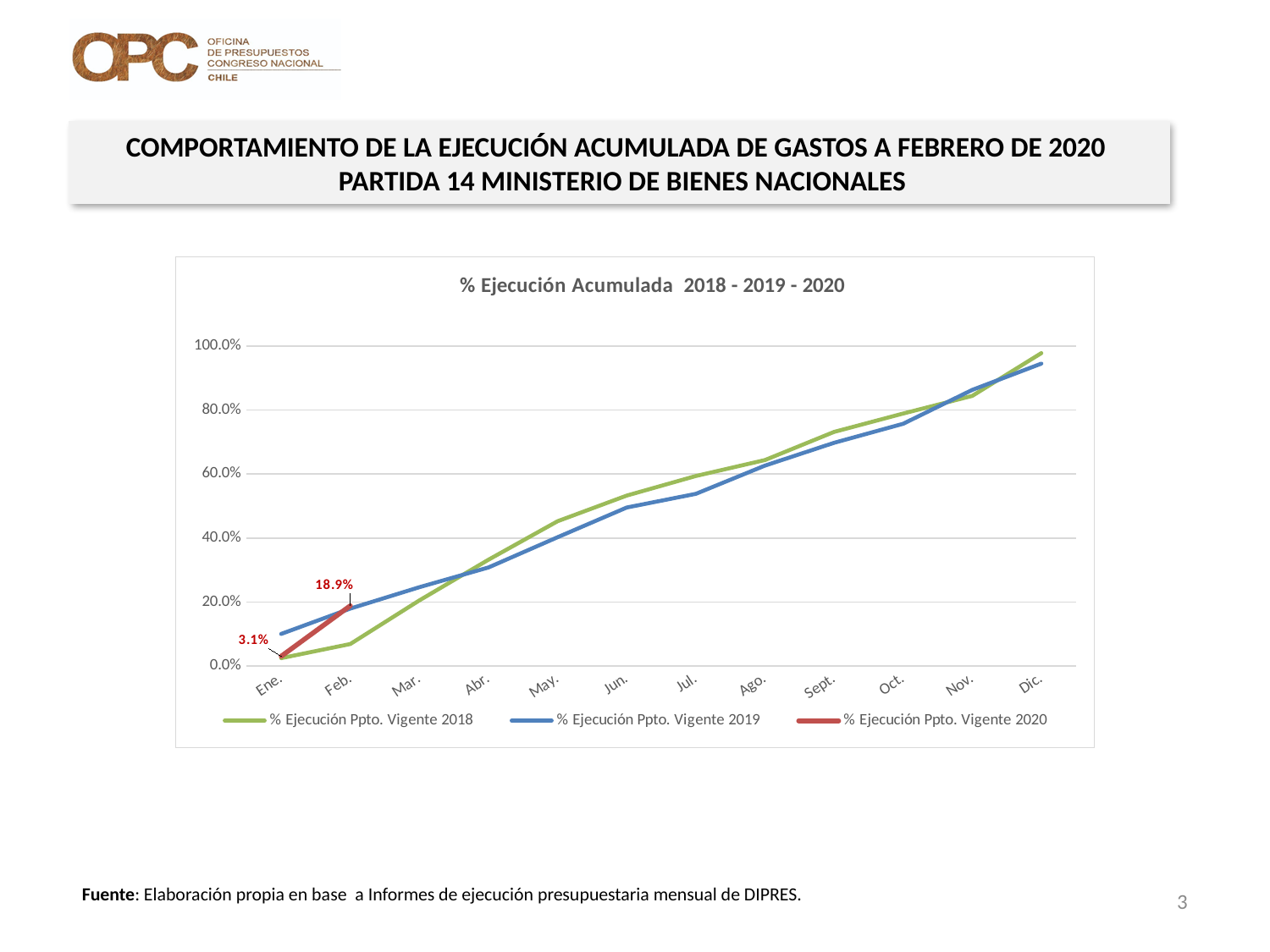
What is the title of the chart? % Ejecución Acumulada 2018 - 2019 - 2020 What is the value of % Ejecución Ppto. Vigente 2020 in Ene.? 3.1% What colour is the line for % Ejecución Ppto. Vigente 2020? Red How many series does the legend list? 3 How many months are shown on the x axis? 12 By how many percentage points did % Ejecución Ppto. Vigente 2020 increase from Ene. to Feb.? 15.8 percentage points In Feb., which series has the larger value: % Ejecución Ppto. Vigente 2018 or % Ejecución Ppto. Vigente 2019? % Ejecución Ppto. Vigente 2019 What is the value of % Ejecución Ppto. Vigente 2020 in Feb.? 18.9% What kind of chart is shown on the slide? Line chart Is the value for % Ejecución Ppto. Vigente 2018 in Feb. greater or less than 20.0%? less Do the values for % Ejecución Ppto. Vigente 2019 rise or fall from Ene. to Dic.? Rise Is the value for % Ejecución Ppto. Vigente 2019 in Dic. greater or less than 80.0%? greater